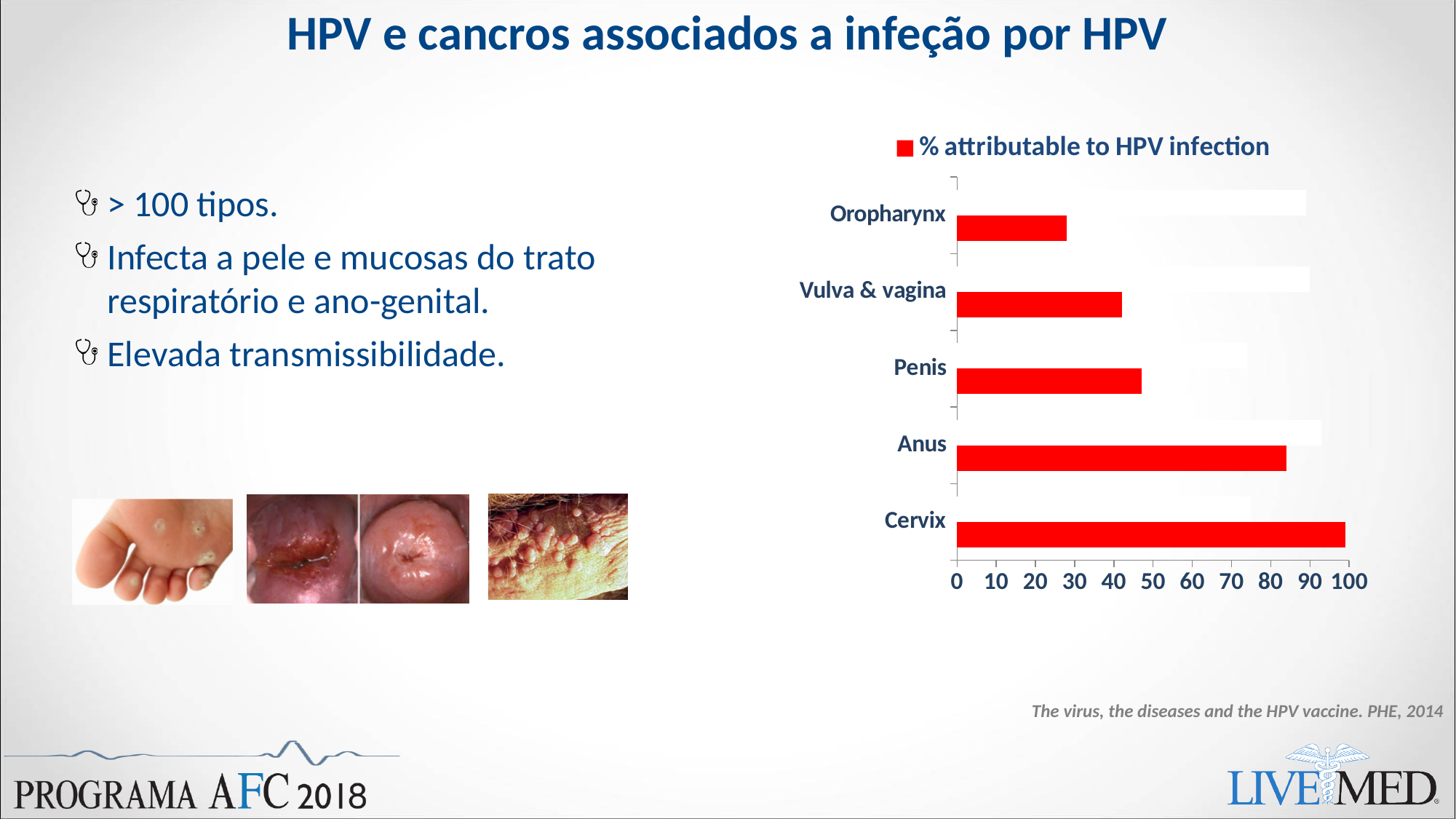
Is the value for Anus greater or less than 70? greater Is the value for Oropharynx greater or less than 40? less What is the series name shown in the chart legend? % attributable to HPV infection How many categories are shown on the chart? 5 What is the maximum value shown on the chart's horizontal axis? 100 Is the value for Cervix greater or less than 90? greater Which category has the lowest % attributable to HPV infection? Oropharynx Which has a higher % attributable to HPV infection, Anus or Penis? Anus Which has a higher % attributable to HPV infection, Oropharynx or Vulva & vagina? Vulva & vagina Which category has the highest % attributable to HPV infection? Cervix What kind of chart is shown on the slide? bar chart How many series does the chart legend list? 1